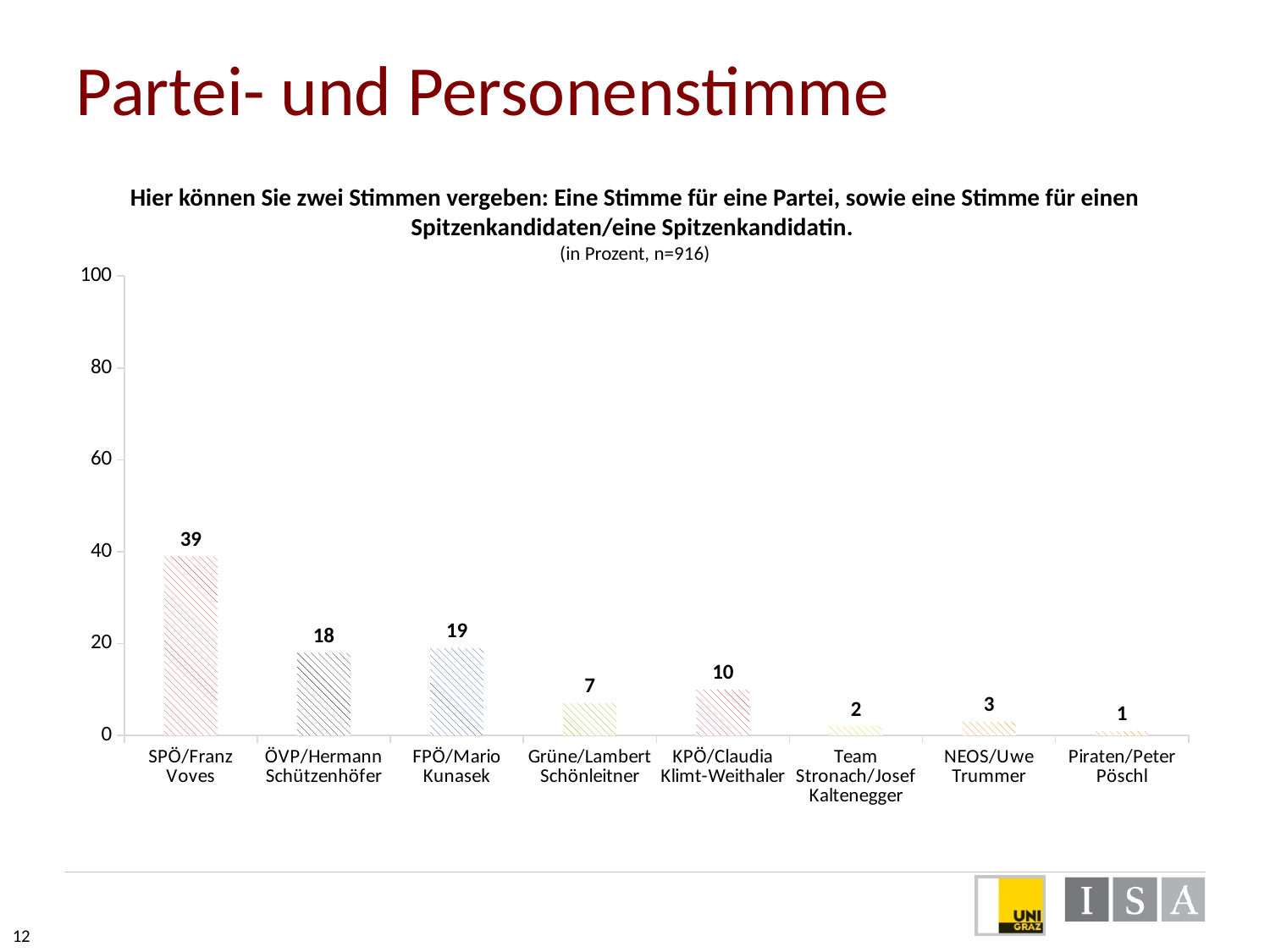
Which category has the highest value? SPÖ/Franz Voves What is the value for SPÖ/Franz Voves? 39 How many categories are shown on the x axis? 8 Is the value for ÖVP/Hermann Schützenhöfer greater or less than 20? less What kind of chart is shown on the slide? bar chart What is the difference between the values for SPÖ/Franz Voves and FPÖ/Mario Kunasek? 20 What is the difference between the values for ÖVP/Hermann Schützenhöfer and Team Stronach/Josef Kaltenegger? 16 What is the value for NEOS/Uwe Trummer? 3 Which is larger, the value for KPÖ/Claudia Klimt-Weithaler or the value for Grüne/Lambert Schönleitner? KPÖ/Claudia Klimt-Weithaler What is the sample size (n) given under the chart title? 916 What is the value for Grüne/Lambert Schönleitner? 7 Which category has the lowest value? Piraten/Peter Pöschl